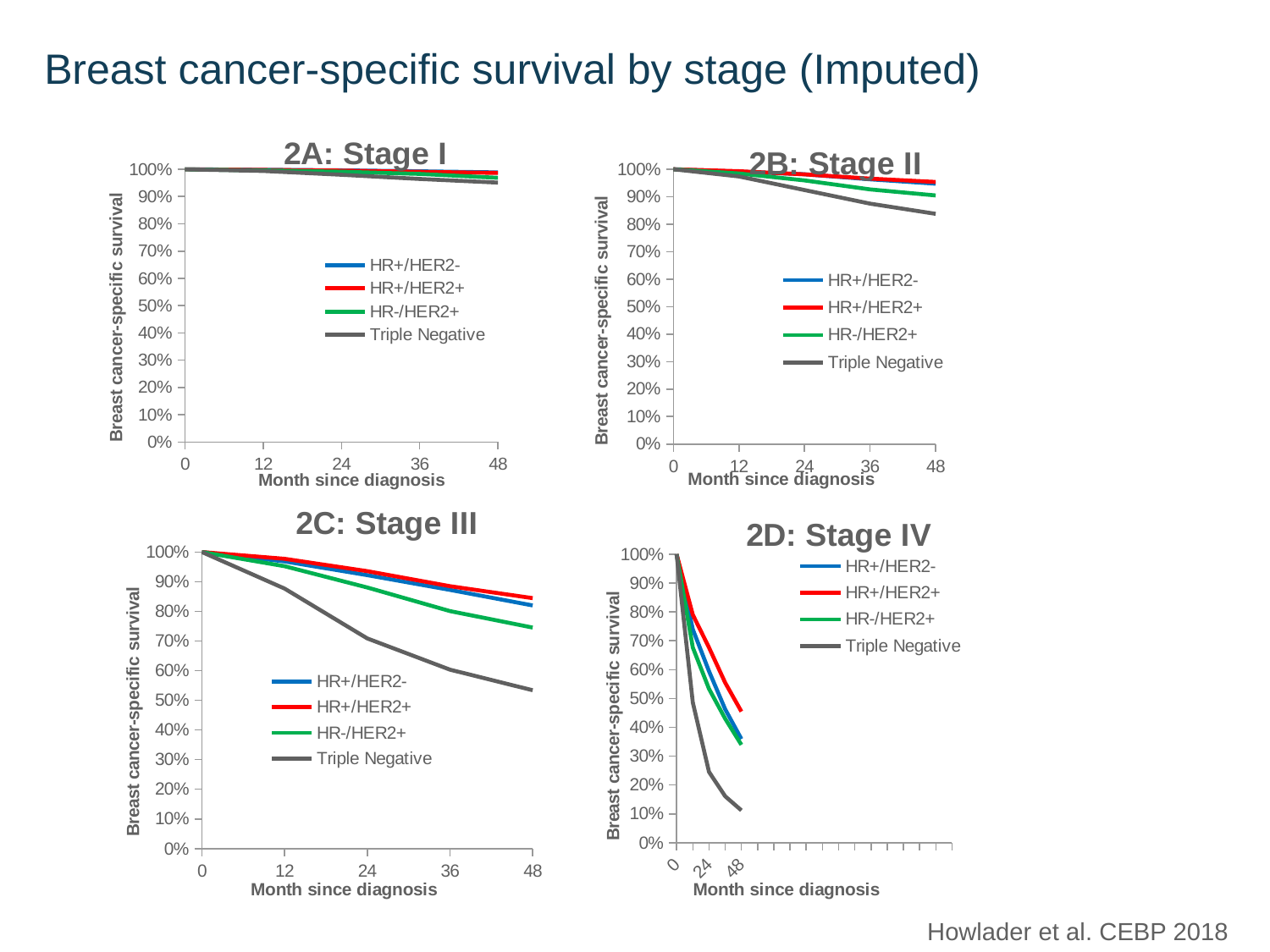
What kind of chart is 2A: Stage I? line chart In 2D: Stage IV, do the survival values rise or fall as months since diagnosis increase? fall In 2C: Stage III, is the Triple Negative value at month 48 greater or less than 60%? less What is the y-axis label on the 2B: Stage II chart? Breast cancer-specific survival In 2D: Stage IV, is the Triple Negative value at month 48 greater or less than 20%? less In 2C: Stage III, which series has the lowest survival at month 48? Triple Negative How many series does the legend of 2C: Stage III list? 4 What is the title of the bottom-left chart? 2C: Stage III In 2C: Stage III, at month 48, which is higher: HR-/HER2+ or Triple Negative? HR-/HER2+ In 2B: Stage II, is the Triple Negative value at month 48 greater or less than 90%? less In 2D: Stage IV, which series has the highest survival at month 48? HR+/HER2+